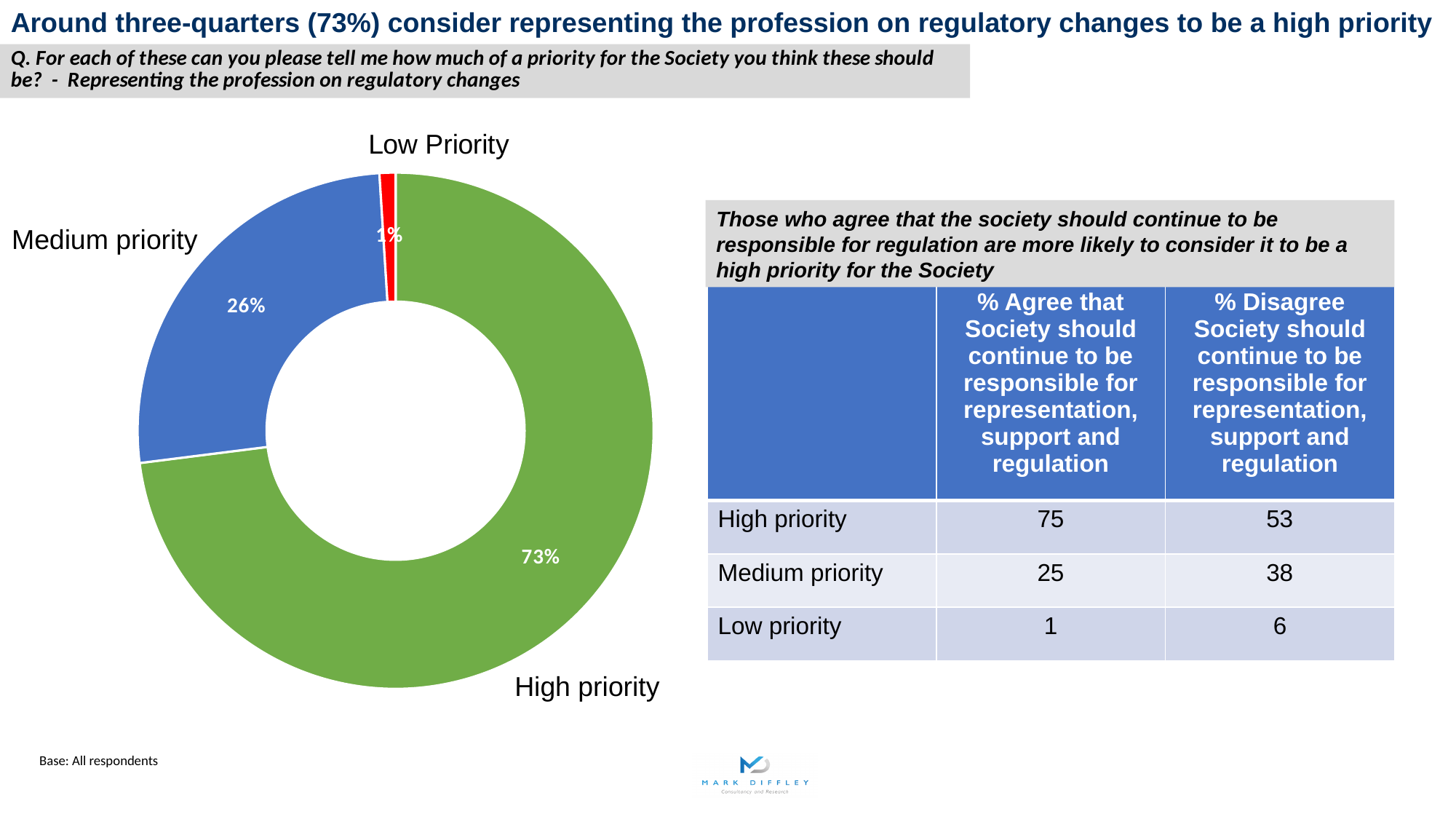
Which is larger, the medium priority share or the low priority share? Medium priority What percentage of respondents rated it a medium priority? 26% What colour is the low priority segment of the donut chart? Red What share of respondents consider representing the profession on regulatory changes a high priority? 73% Is the medium priority share greater or less than 50%? less Which priority level has the smallest share of the donut chart? Low Priority What is the difference in percentage points between the high priority and medium priority shares? 47 Which priority level has the largest share of the donut chart? High priority What percentage of respondents rated it a low priority? 1% What colour is the high priority segment of the donut chart? Green What type of chart is used to show the priority breakdown? Donut (pie) chart How many categories are shown in the donut chart? 3